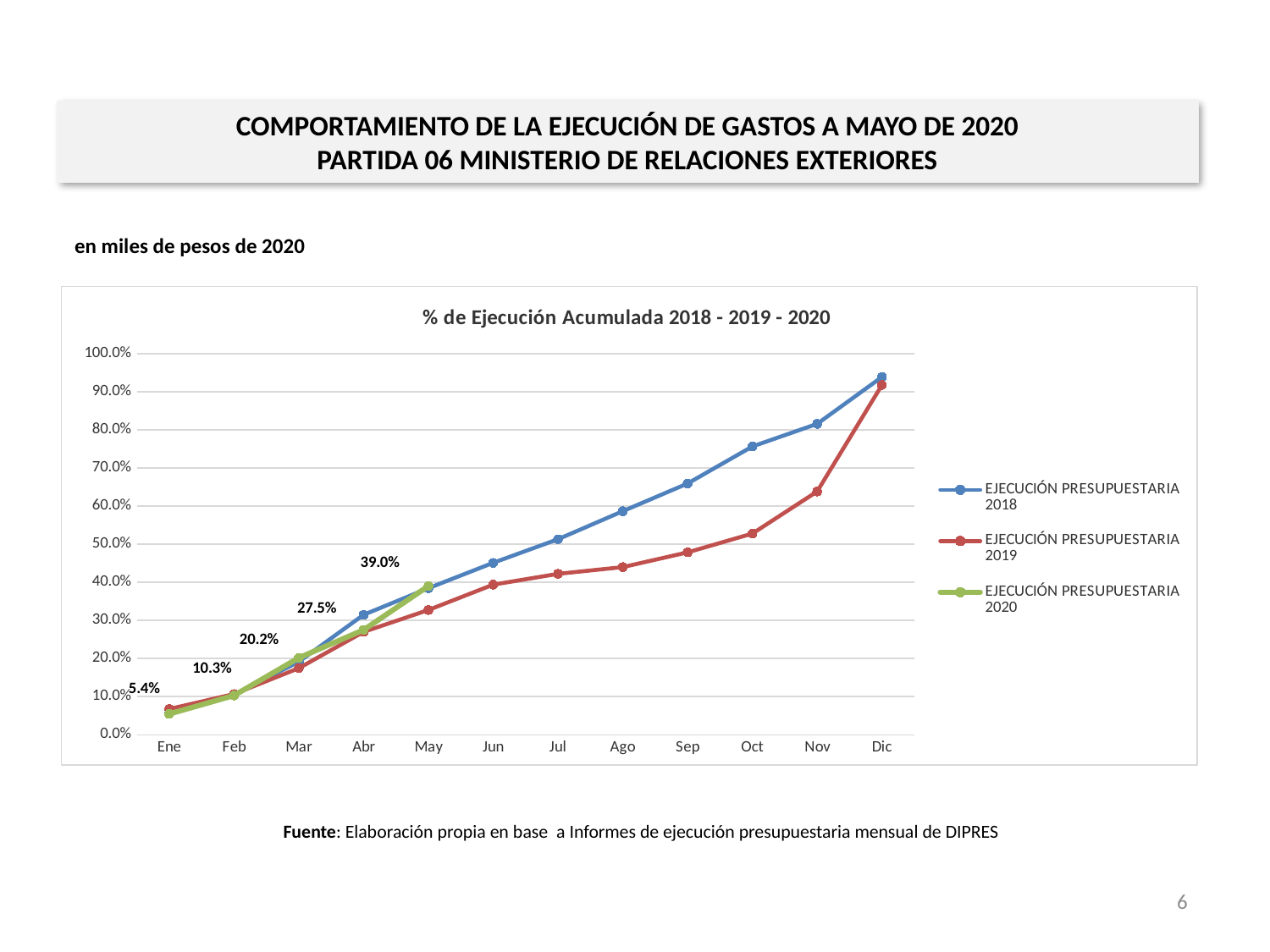
Is the value for EJECUCIÓN PRESUPUESTARIA 2018 in Oct greater or less than 70.0%? greater How many months are shown along the x axis? 12 What is the difference between the 2020 values for Feb and Ene? 4.9% How many series does the legend list? 3 What is the value for EJECUCIÓN PRESUPUESTARIA 2020 in Mar? 20.2% What is the difference between the 2020 values for May and Abr? 11.5% What is the title of the chart? % de Ejecución Acumulada 2018 - 2019 - 2020 What is the value for EJECUCIÓN PRESUPUESTARIA 2020 in Ene? 5.4% In Oct, which series has the larger value, EJECUCIÓN PRESUPUESTARIA 2018 or EJECUCIÓN PRESUPUESTARIA 2019? EJECUCIÓN PRESUPUESTARIA 2018 What is the value for EJECUCIÓN PRESUPUESTARIA 2020 in May? 39.0% Is the value for EJECUCIÓN PRESUPUESTARIA 2019 in Nov greater or less than 70.0%? less What kind of chart is shown on the slide? line chart